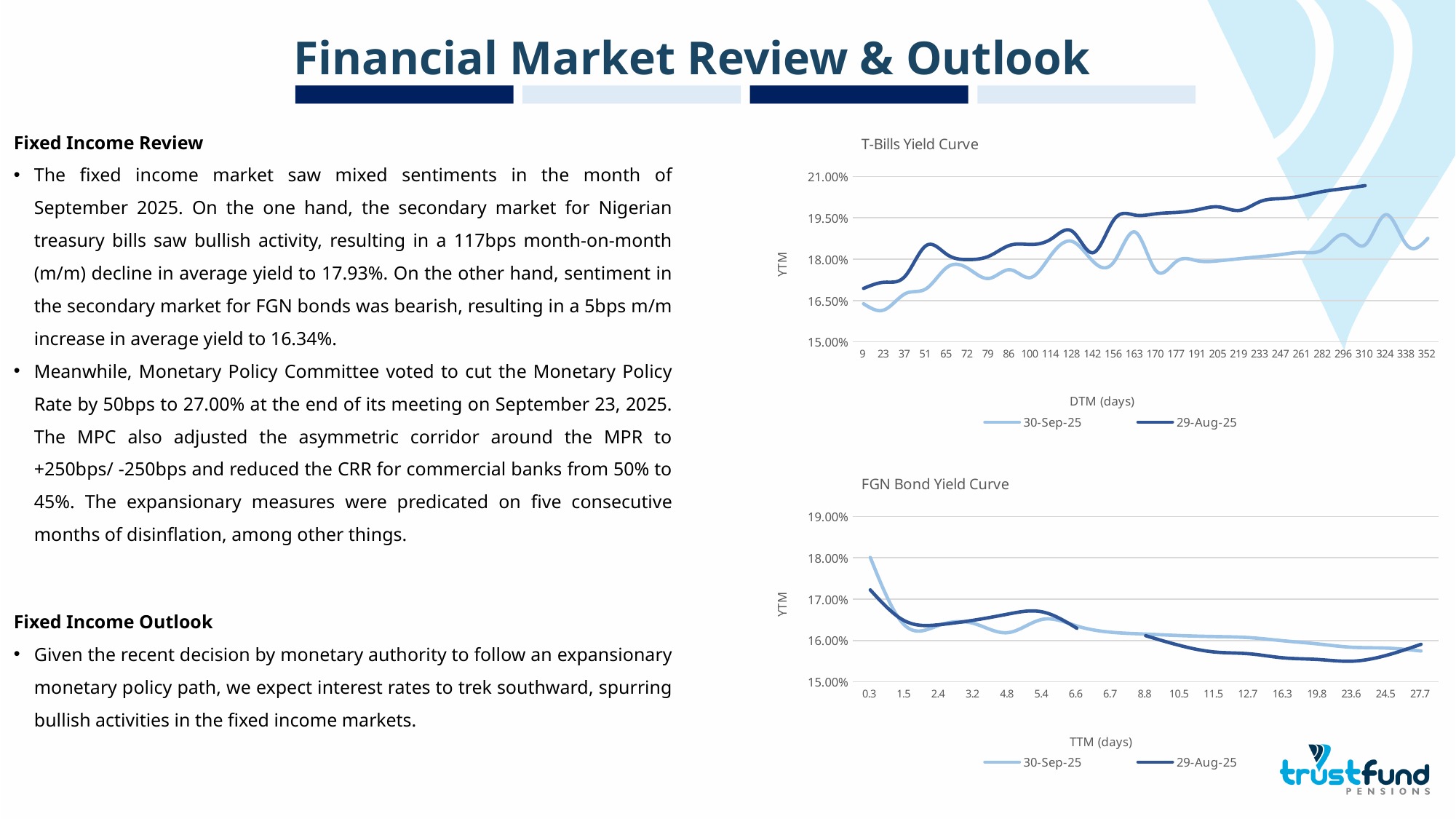
In the FGN Bond Yield Curve chart, which series has the higher value at 19.8, 30-Sep-25 or 29-Aug-25? 30-Sep-25 How many points are marked on the x axis of the FGN Bond Yield Curve chart? 17 What is the x-axis label of the FGN Bond Yield Curve chart? TTM (days) In the T-Bills Yield Curve chart, does the 29-Aug-25 series generally rise or fall as days to maturity increase? Rise In the T-Bills Yield Curve chart, is the 30-Sep-25 value at 9 days greater or less than 18.00%? less How many points are marked on the x axis of the T-Bills Yield Curve chart? 28 In the FGN Bond Yield Curve chart, is the 29-Aug-25 value at 23.6 greater or less than 16.00%? less How many series does the legend of the FGN Bond Yield Curve chart list? 2 In the T-Bills Yield Curve chart, what are the two series named in the legend? 30-Sep-25 and 29-Aug-25 What kind of chart is the T-Bills Yield Curve chart? Line chart In the T-Bills Yield Curve chart, which series has the higher value at 310 days, 30-Sep-25 or 29-Aug-25? 29-Aug-25 In the T-Bills Yield Curve chart, is the 29-Aug-25 value at 310 days greater or less than 19.50%? greater